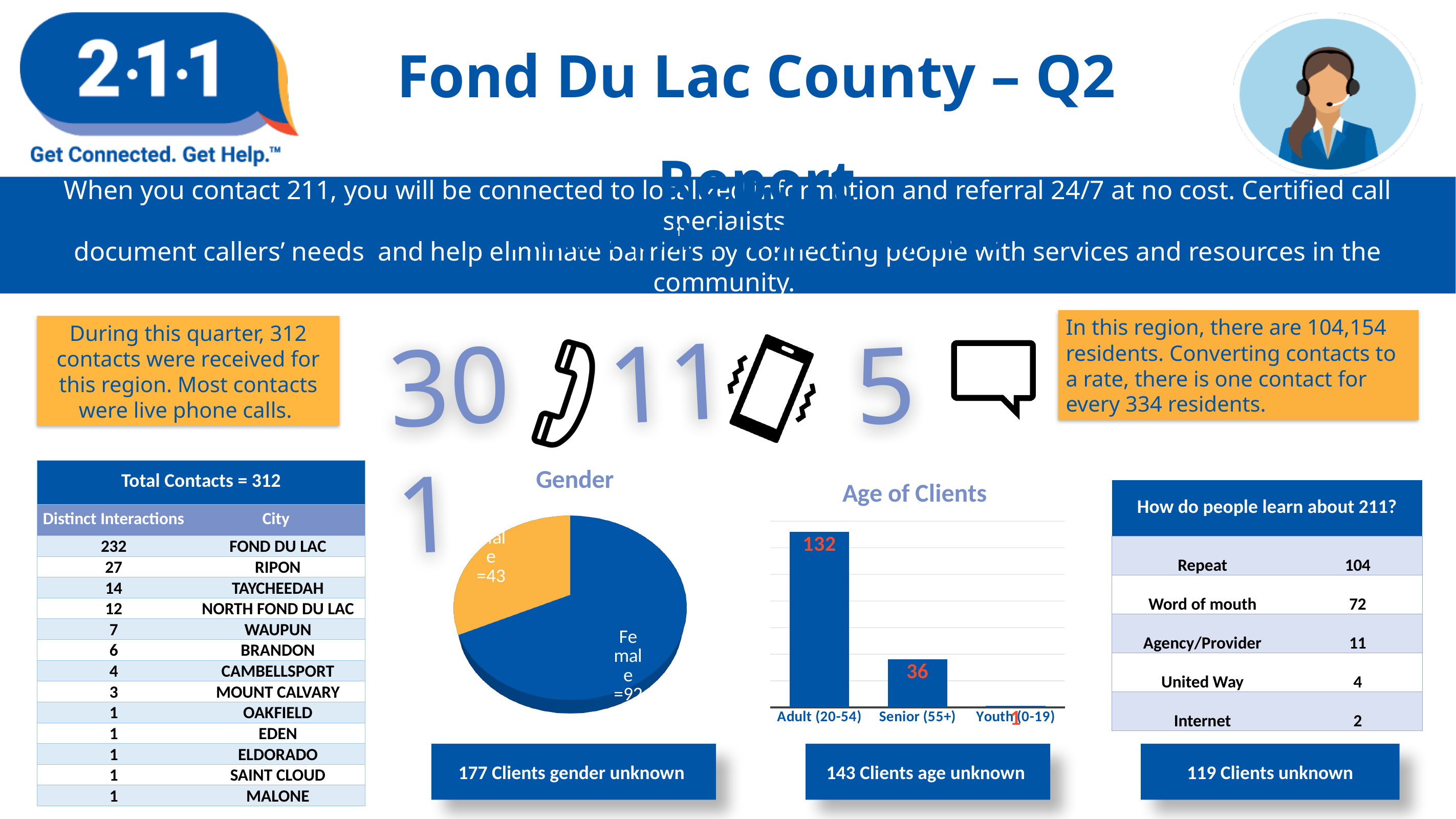
In the Age of Clients chart, what is the value for Youth (0-19)? 1 In the Age of Clients chart, what is the value for Senior (55+)? 36 In the Age of Clients chart, how many age categories are shown? 3 In the Age of Clients chart, do the values rise or fall from left to right across the categories? Fall In the Age of Clients chart, which age group has the lowest value? Youth (0-19) What kind of chart is the Gender chart? Pie chart In the Age of Clients chart, what is the difference between the Adult (20-54) and Senior (55+) values? 96 What kind of chart is the Age of Clients chart? Bar chart In the Age of Clients chart, what is the value for Adult (20-54)? 132 In the Gender chart, what is the value for Male? 43 In the Gender chart, which slice is larger, Male or Female? Female In the Age of Clients chart, which age group has the highest value? Adult (20-54)